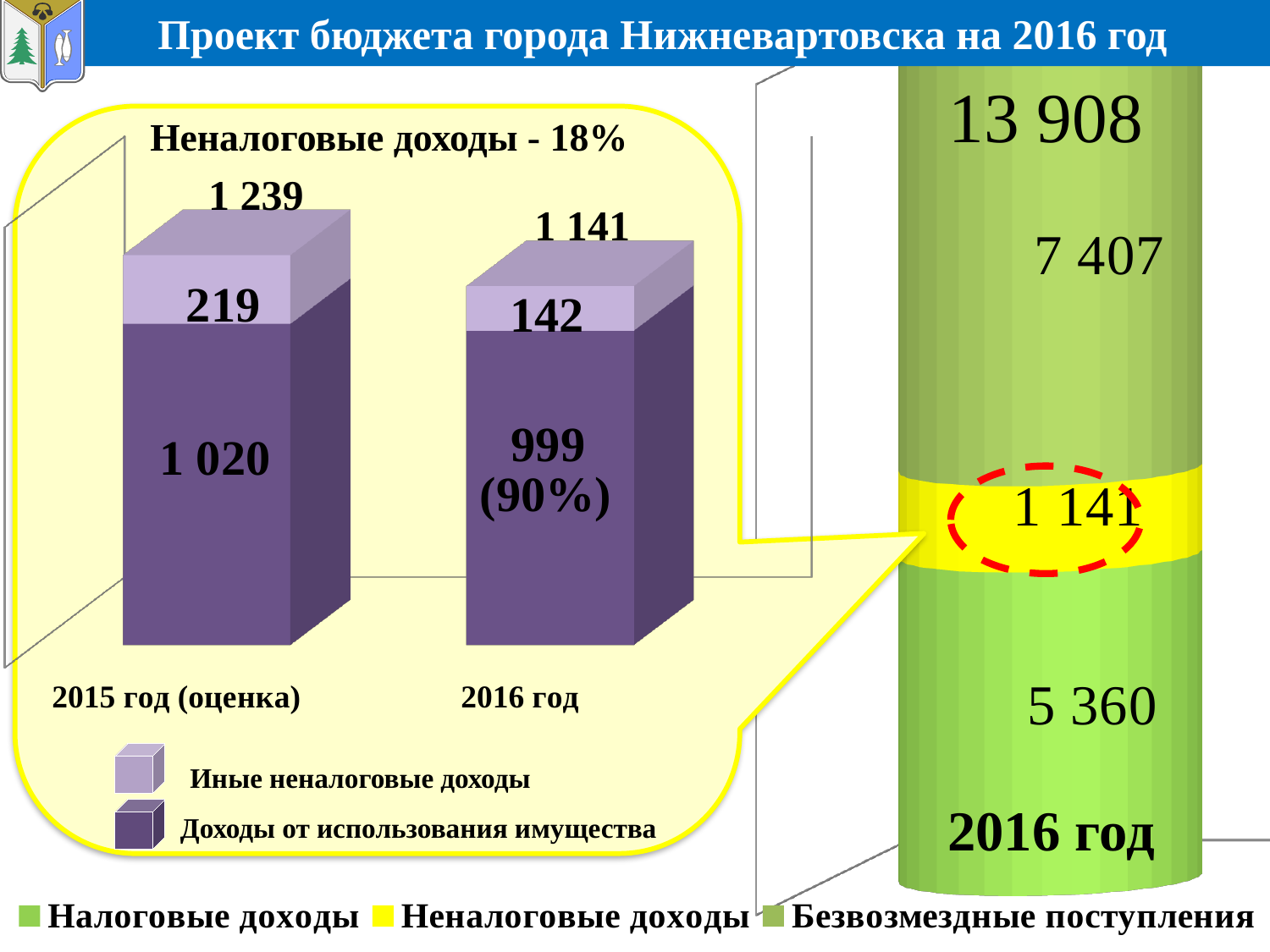
In the chart titled "Неналоговые доходы - 18%", which year has the larger total, "2015 год (оценка)" or "2016 год"? 2015 год (оценка) In the chart titled "Неналоговые доходы - 18%", how many series does the legend list? 2 In the chart titled "Неналоговые доходы - 18%", what is the value of "Иные неналоговые доходы" for "2016 год"? 142 In the stacked column on the right of the slide for "2016 год", what is the total shown at the top of the column? 13 908 In the stacked column on the right of the slide for "2016 год", which segment is the largest? Безвозмездные поступления In the stacked column on the right of the slide for "2016 год", what is the value of "Налоговые доходы"? 5 360 In the chart titled "Неналоговые доходы - 18%", what is the value of "Доходы от использования имущества" for "2015 год (оценка)"? 1 020 In the chart titled "Неналоговые доходы - 18%", what is the difference between the "Иные неналоговые доходы" values for "2015 год (оценка)" and "2016 год"? 77 In the chart titled "Неналоговые доходы - 18%", what kind of chart is shown? Stacked bar chart In the chart titled "Неналоговые доходы - 18%", what is the total of the stacked bar for "2016 год"? 1 141 In the chart titled "Неналоговые доходы - 18%", what is the total of the stacked bar for "2015 год (оценка)"? 1 239 In the chart titled "Неналоговые доходы - 18%", do the totals rise or fall from "2015 год (оценка)" to "2016 год"? Fall